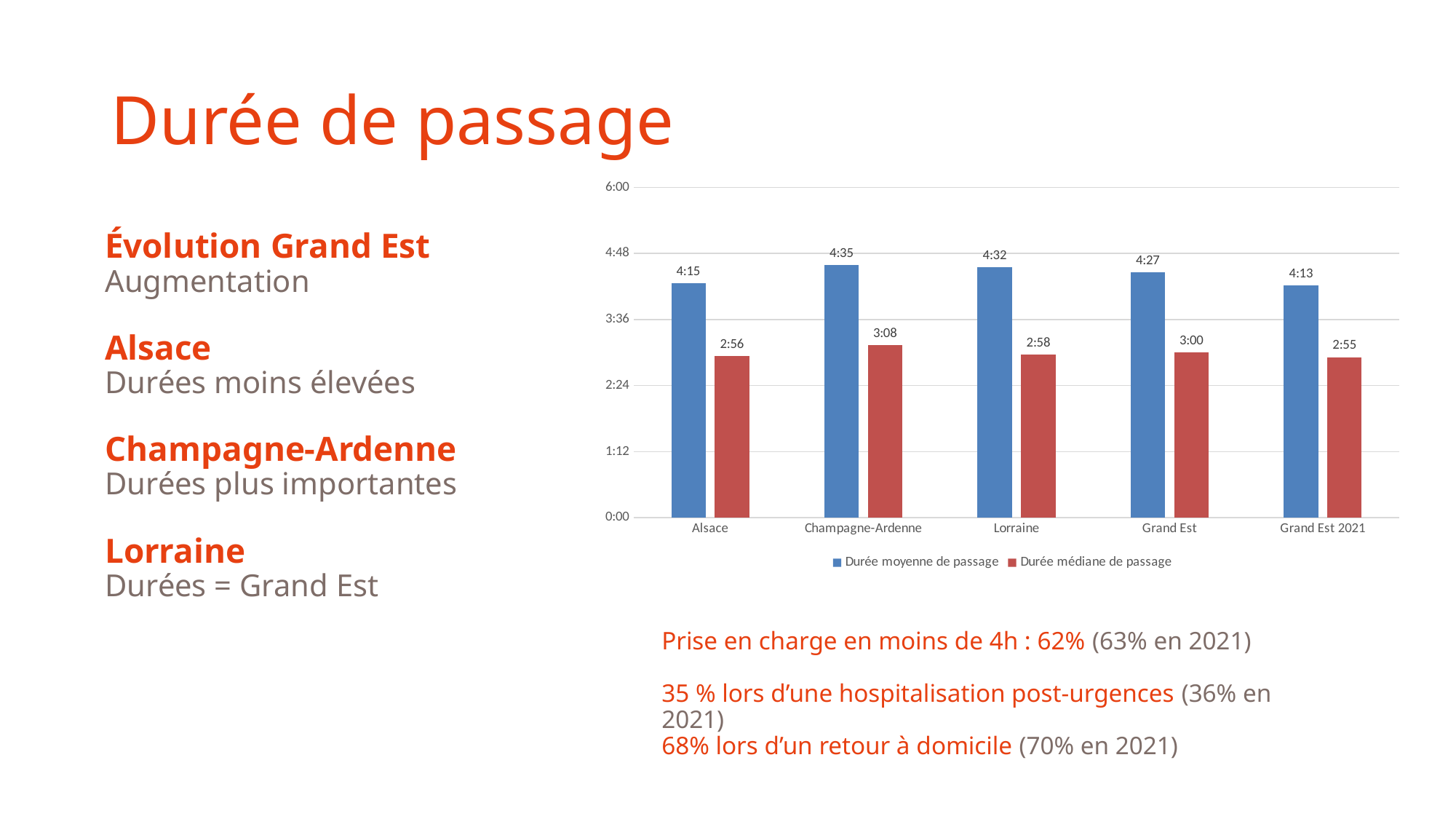
Is the Durée moyenne de passage for Alsace greater or less than the Durée moyenne de passage for Lorraine? less Which category has the highest Durée moyenne de passage? Champagne-Ardenne How many categories are shown on the x axis? 5 What type of chart is shown on the slide? Bar chart What is the Durée moyenne de passage for Champagne-Ardenne? 4:35 How many series does the legend list? 2 What is the Durée médiane de passage for Alsace? 2:56 What is the Durée moyenne de passage for Grand Est 2021? 4:13 Which category has the lowest Durée médiane de passage? Grand Est 2021 Is the Durée médiane de passage for Grand Est greater or less than 3:36? less Which series is shown in blue in the legend? Durée moyenne de passage What is the difference in minutes between the Durée moyenne de passage for Champagne-Ardenne (4:35) and for Alsace (4:15)? 20 minutes